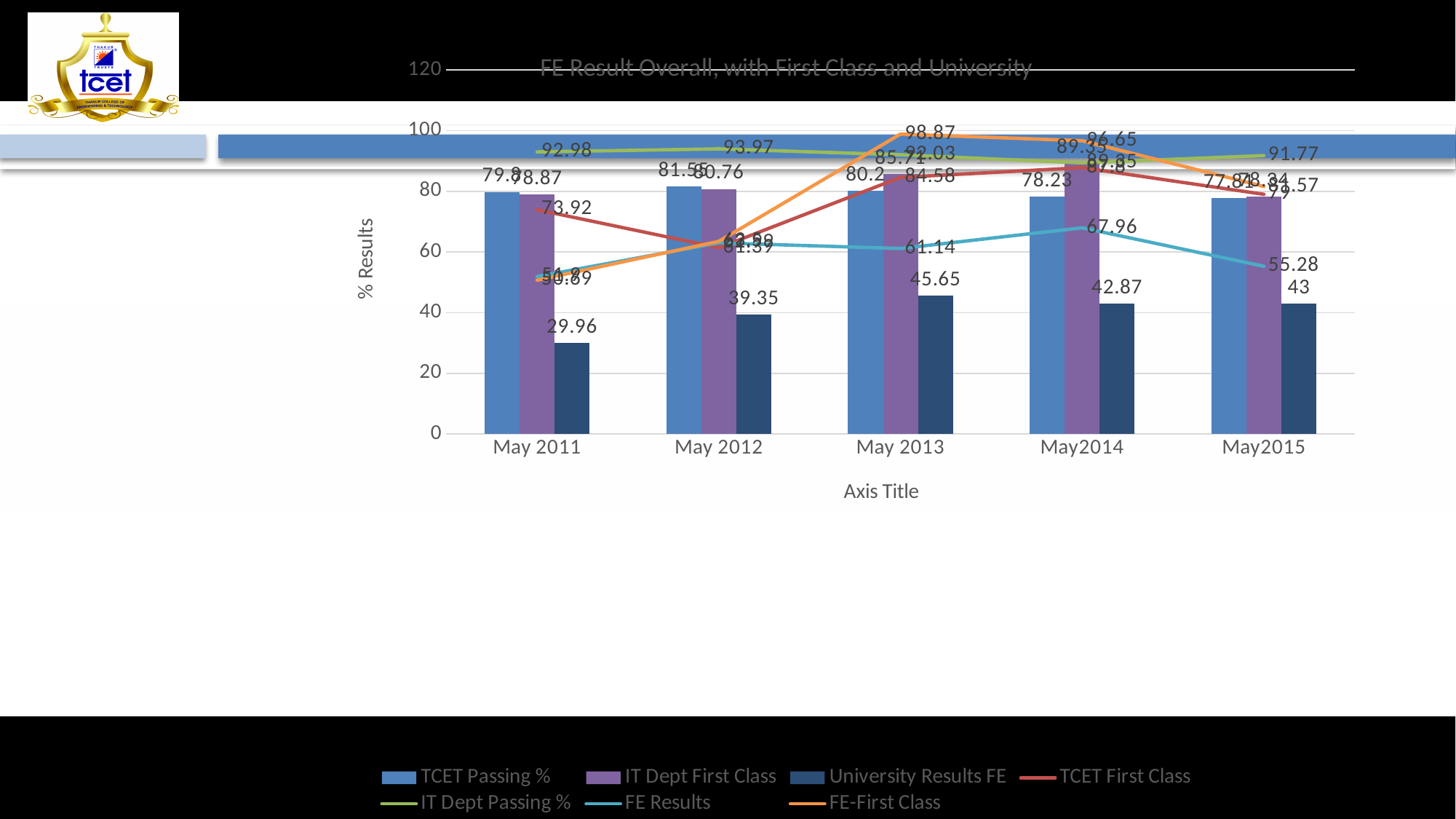
In which year is University Results FE highest? May 2013 What is the FE-First Class value for May 2013? 98.87 What is the value of IT Dept First Class for May2014? 89.35 How many series does the legend list? 7 What is the difference between University Results FE in May 2013 and May 2011? 15.69 In which year is University Results FE lowest? May 2011 What is the value of University Results FE for May 2011? 29.96 What is the label of the y axis? % Results Is the FE Results value for May 2011 greater or less than 60? less In May2014, which is larger: TCET Passing % or IT Dept First Class? IT Dept First Class What is the FE Results value for May2015? 55.28 How many years are shown on the x axis? 5